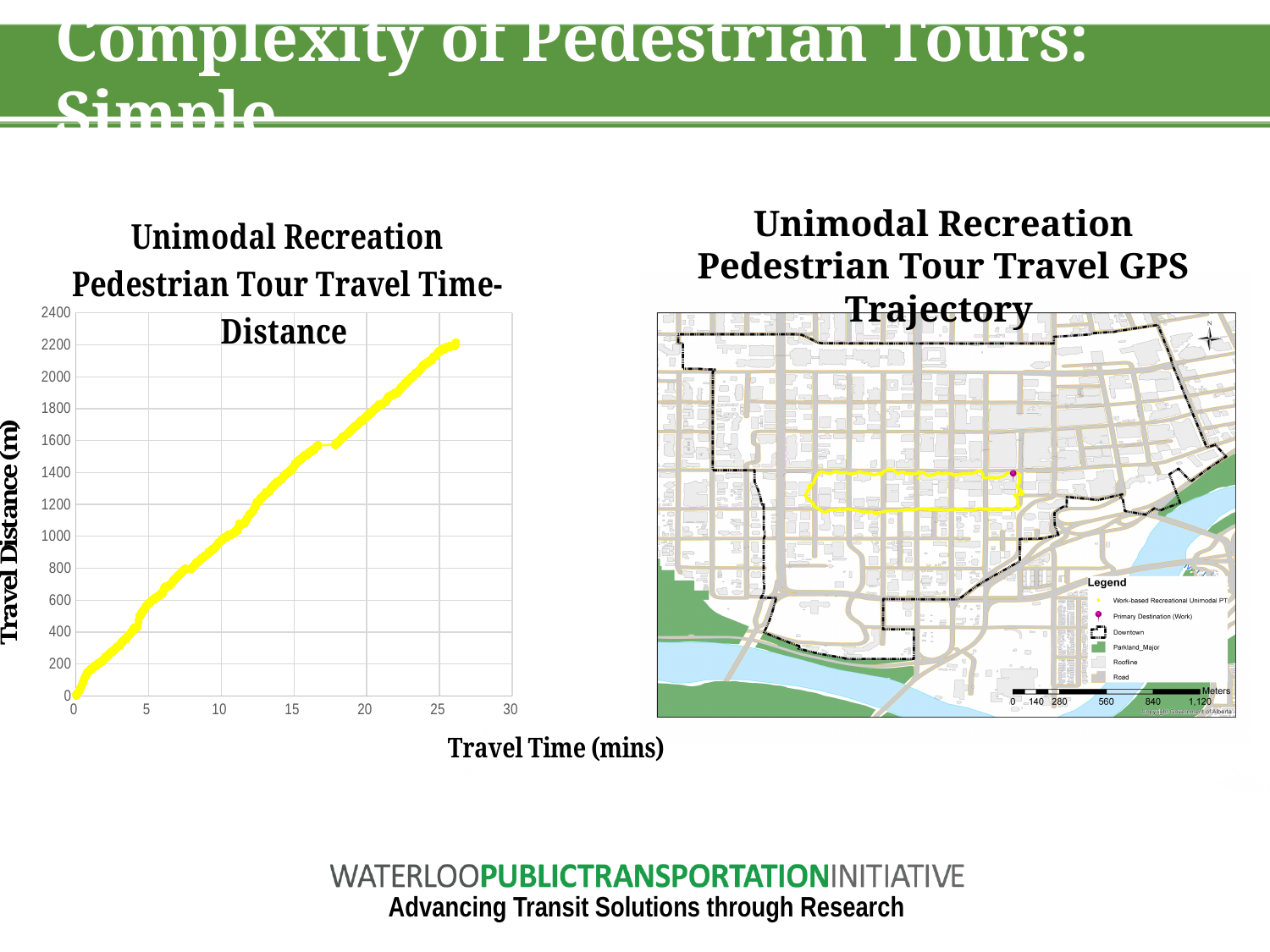
In the 'Unimodal Recreation Pedestrian Tour Travel Time-Distance' chart, is the travel distance at 25 minutes greater or less than 2000? greater In the 'Unimodal Recreation Pedestrian Tour Travel Time-Distance' chart, is the travel distance at 5 minutes greater or less than 400? greater What is the label of the x axis on the 'Unimodal Recreation Pedestrian Tour Travel Time-Distance' chart? Travel Time (mins) What is the label of the y axis on the 'Unimodal Recreation Pedestrian Tour Travel Time-Distance' chart? Travel Distance (m) What kind of chart is the 'Unimodal Recreation Pedestrian Tour Travel Time-Distance' chart? scatter chart In the 'Unimodal Recreation Pedestrian Tour Travel Time-Distance' chart, is the travel distance at 10 minutes greater or less than 1400? less In the 'Unimodal Recreation Pedestrian Tour Travel Time-Distance' chart, do the plotted values rise or fall as travel time increases? rise